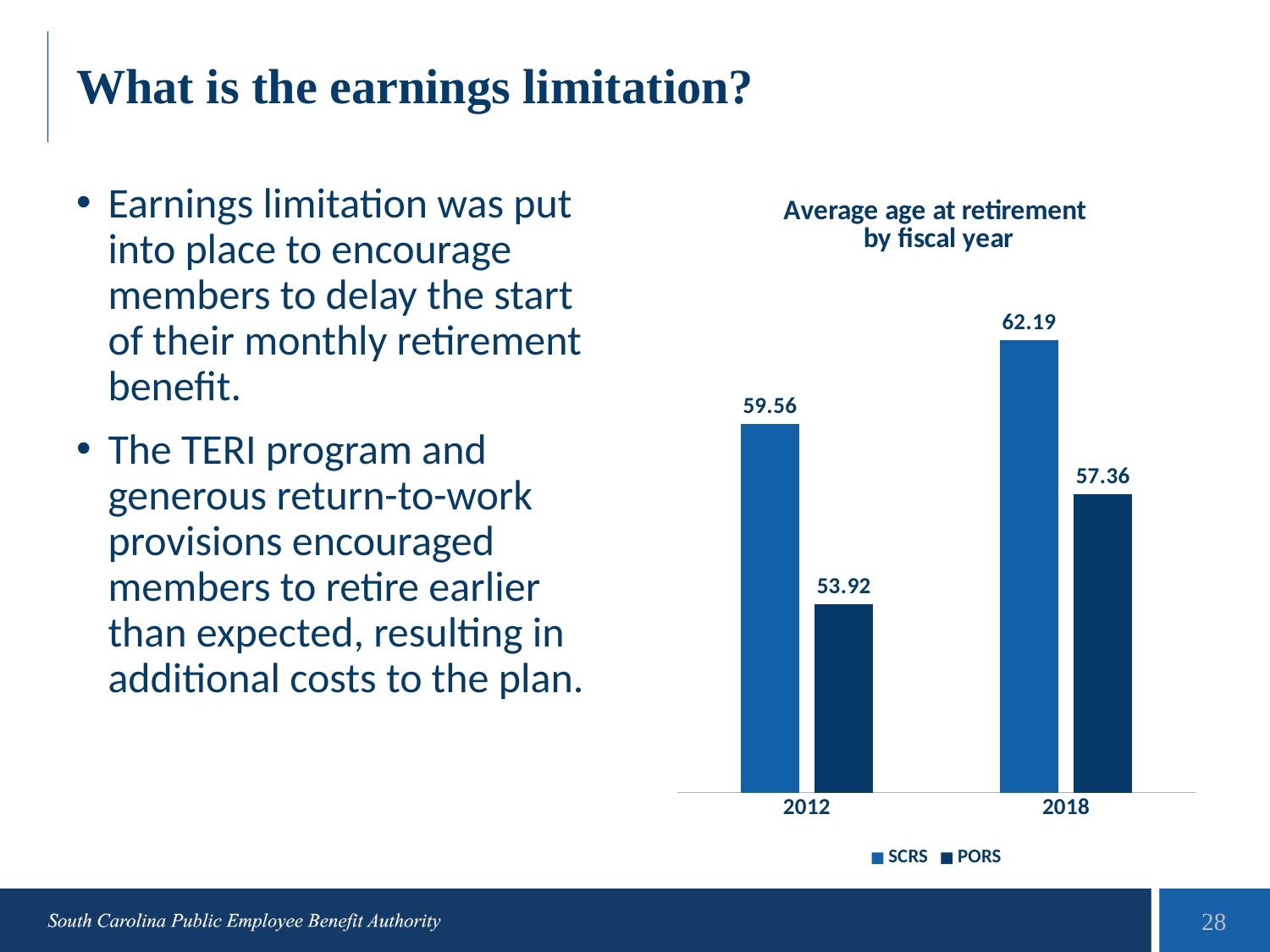
What is the average age at retirement for SCRS in 2012? 59.56 What is the average age at retirement for PORS in 2018? 57.36 By how much did the SCRS average age at retirement increase from 2012 to 2018? 2.63 What type of chart is shown on the slide? Bar chart How many fiscal years are shown on the x axis? 2 Which is larger in 2012, the SCRS or the PORS average age at retirement? SCRS What is the average age at retirement for PORS in 2012? 53.92 What is the difference between the SCRS and PORS average retirement ages in 2018? 4.83 What is the average age at retirement for SCRS in 2018? 62.19 Which series and year has the lowest average age at retirement? PORS in 2012 How many series does the legend list? 2 Which series and year has the highest average age at retirement? SCRS in 2018